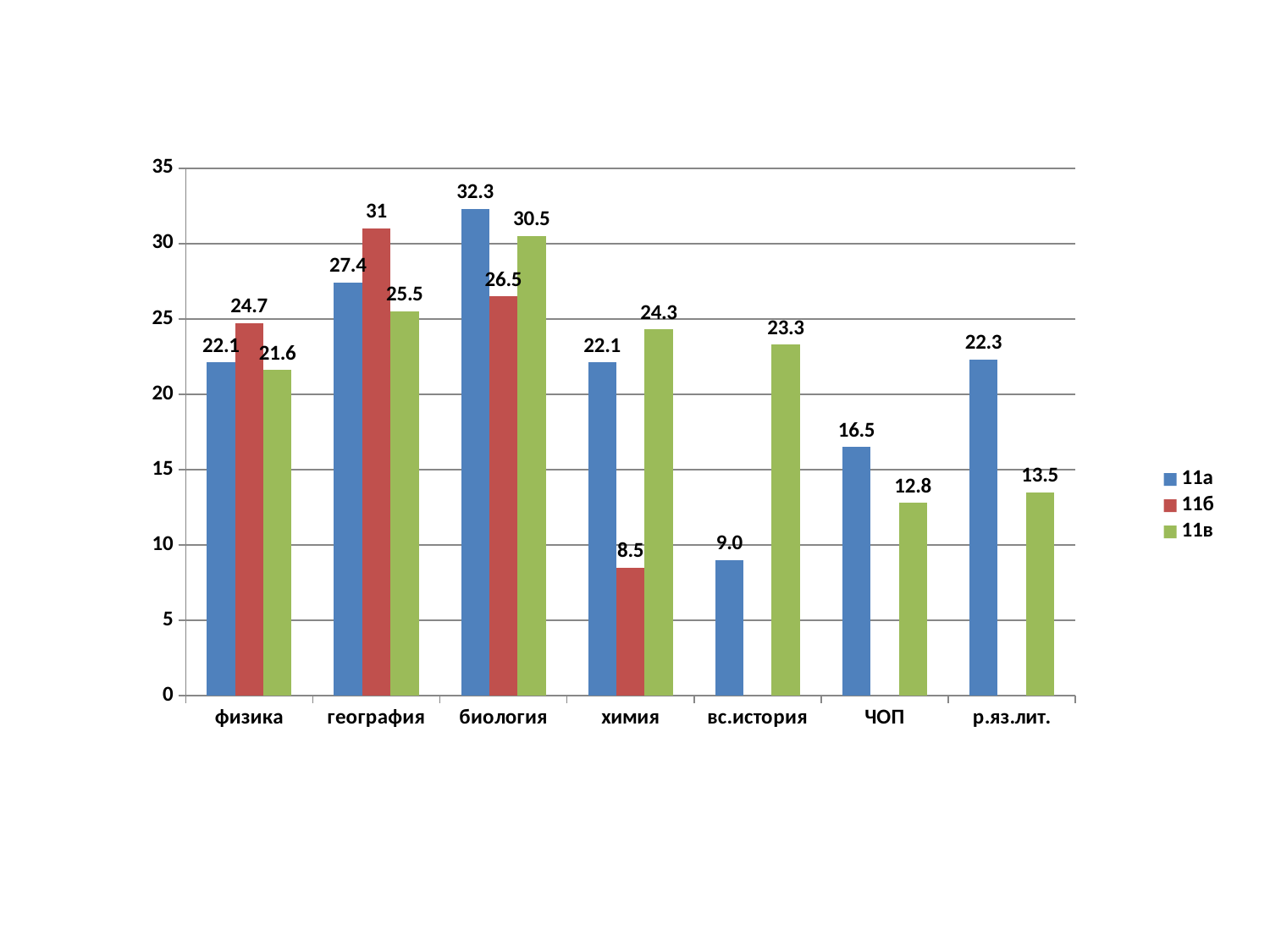
What is the value for 11б in химия? 8.5 Which category has the highest value for the 11б series? география How many categories are shown on the x axis? 7 How many series does the legend list? 3 Which category has the lowest value for the 11а series? вс.история Which is larger in физика: the value for 11б or the value for 11в? 11б Is the value for 11в in ЧОП greater or less than 15? less What is the value for 11в in вс.история? 23.3 What is the value for 11а in биология? 32.3 Which colour represents the 11в series in the legend? green What kind of chart is shown on the slide? bar chart What is the difference between the 11а and 11в values in география? 1.9